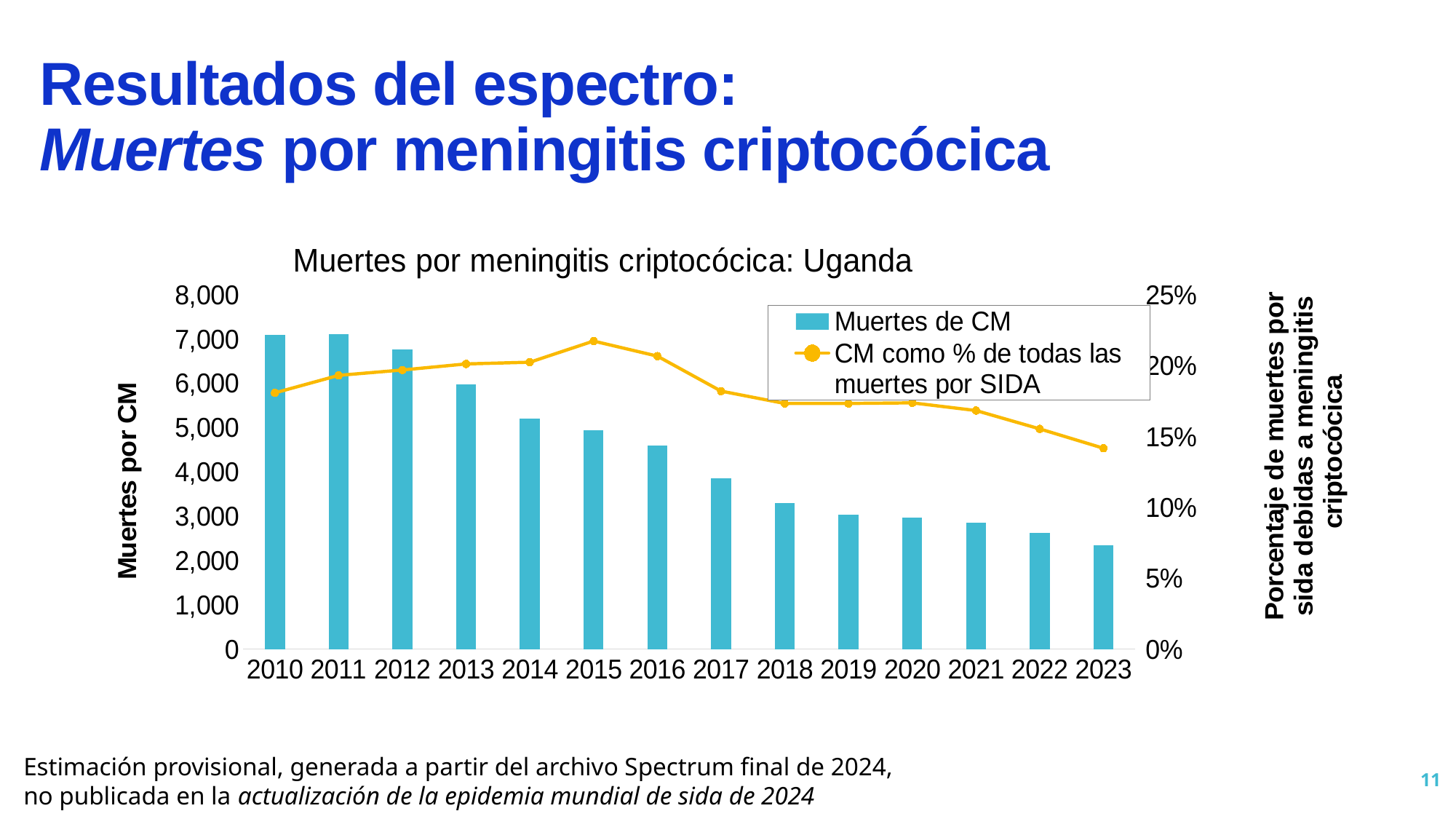
How many series does the legend list? 2 Is the value of 'CM como % de todas las muertes por SIDA' for 2010 greater or less than 20%? less Do the Muertes de CM bars rise or fall from 2010 to 2023? Fall Is the value of Muertes de CM for 2018 greater or less than 4,000? less Which year has the lowest number of Muertes de CM? 2023 In which year does the line 'CM como % de todas las muertes por SIDA' reach its highest value? 2015 What kind of chart is shown on the slide? A combination bar and line chart Which year has more Muertes de CM, 2013 or 2019? 2013 How many years are shown on the x axis? 14 Is the value of 'CM como % de todas las muertes por SIDA' for 2015 greater or less than 20%? greater What is the title of the chart? Muertes por meningitis criptocócica: Uganda